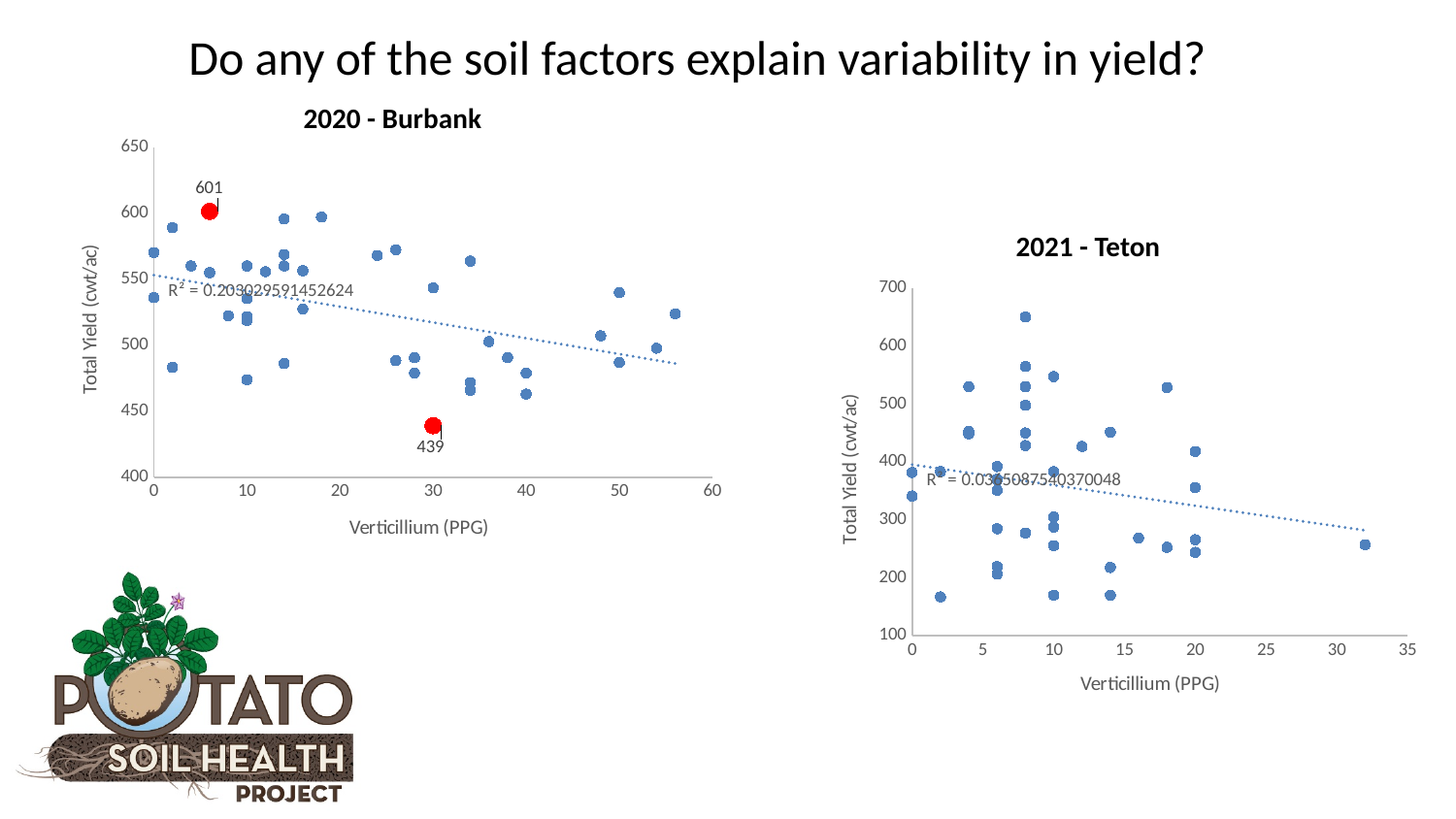
Which chart shows the larger R² value, '2020 - Burbank' or '2021 - Teton'? 2020 - Burbank In the '2020 - Burbank' chart, is the yield of the point with the highest Verticillium value (around 56 PPG) greater or less than 500? greater What kind of chart is the '2020 - Burbank' chart? scatter chart In the '2020 - Burbank' chart, what is the value of the lowest labeled data point (the red point near the bottom)? 439 What is the x-axis title of the '2021 - Teton' chart? Verticillium (PPG) In the '2020 - Burbank' chart, what is the value of the highest labeled data point (the red point near the top)? 601 In the '2020 - Burbank' chart, what is the difference between the two labeled red points, 601 and 439? 162 What is the y-axis title of the '2020 - Burbank' chart? Total Yield (cwt/ac) What is the R² value shown on the '2020 - Burbank' chart? 0.203029591452624 In the '2021 - Teton' chart, is the highest plotted yield value greater or less than 600? greater In the '2020 - Burbank' chart, does the dotted trend line rise or fall as Verticillium (PPG) increases? fall In the '2021 - Teton' chart, does the dotted trend line rise or fall as Verticillium (PPG) increases? fall